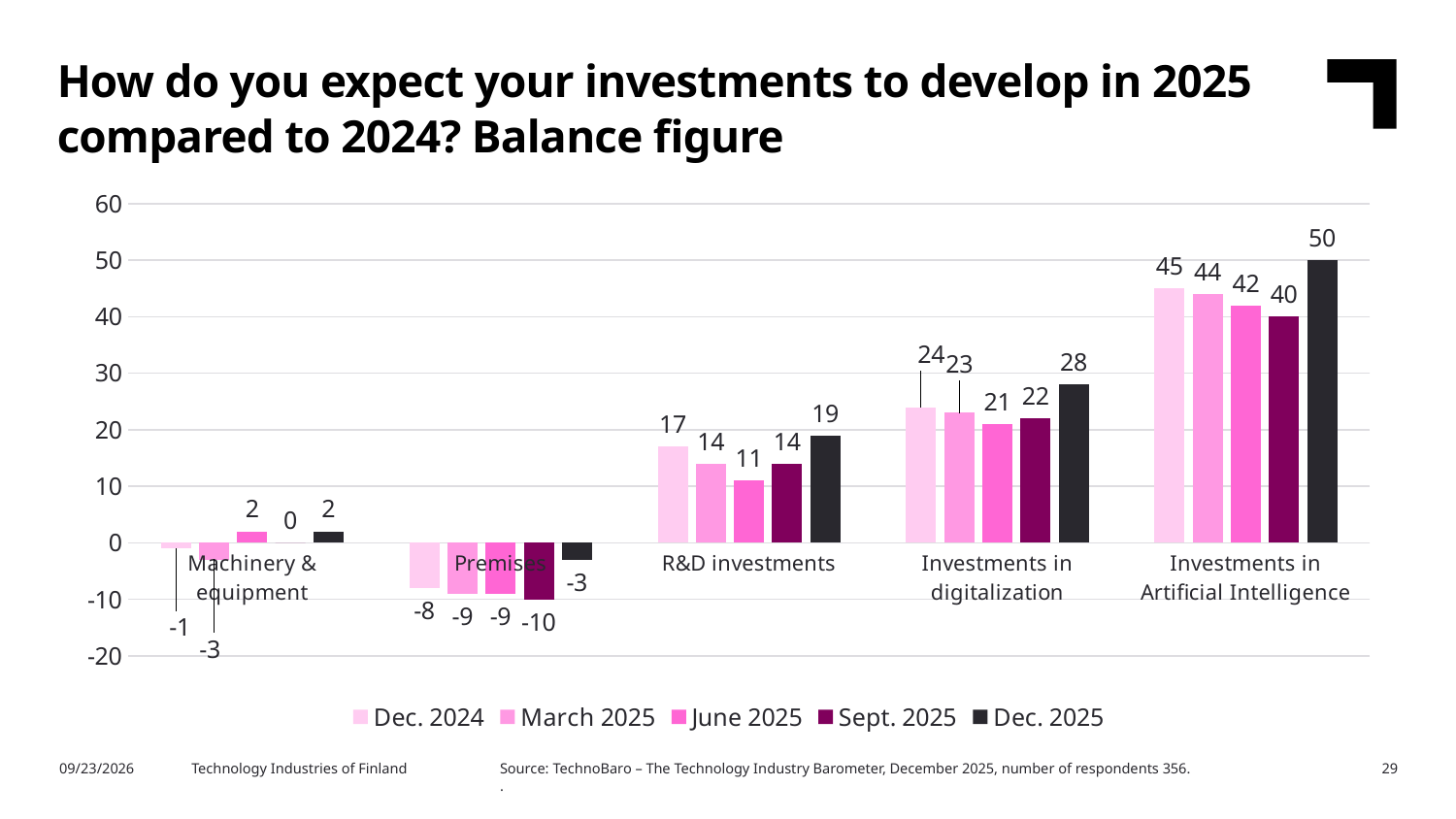
What is the June 2025 value for R&D investments? 11 How many categories are shown on the x axis? 5 What kind of chart is shown on the slide? Bar chart What is the Dec. 2024 value for Investments in digitalization? 24 Which series is shown in black in the legend? Dec. 2025 How many series does the legend list? 5 What is the Dec. 2025 value for Investments in Artificial Intelligence? 50 Which is larger for Investments in digitalization: the March 2025 value or the Dec. 2025 value? Dec. 2025 What is the Sept. 2025 value for Premises? -10 Which category has the lowest Dec. 2024 value? Premises What is the difference between the Dec. 2025 and Dec. 2024 values for Investments in Artificial Intelligence? 5 Which category has the highest Dec. 2025 value? Investments in Artificial Intelligence